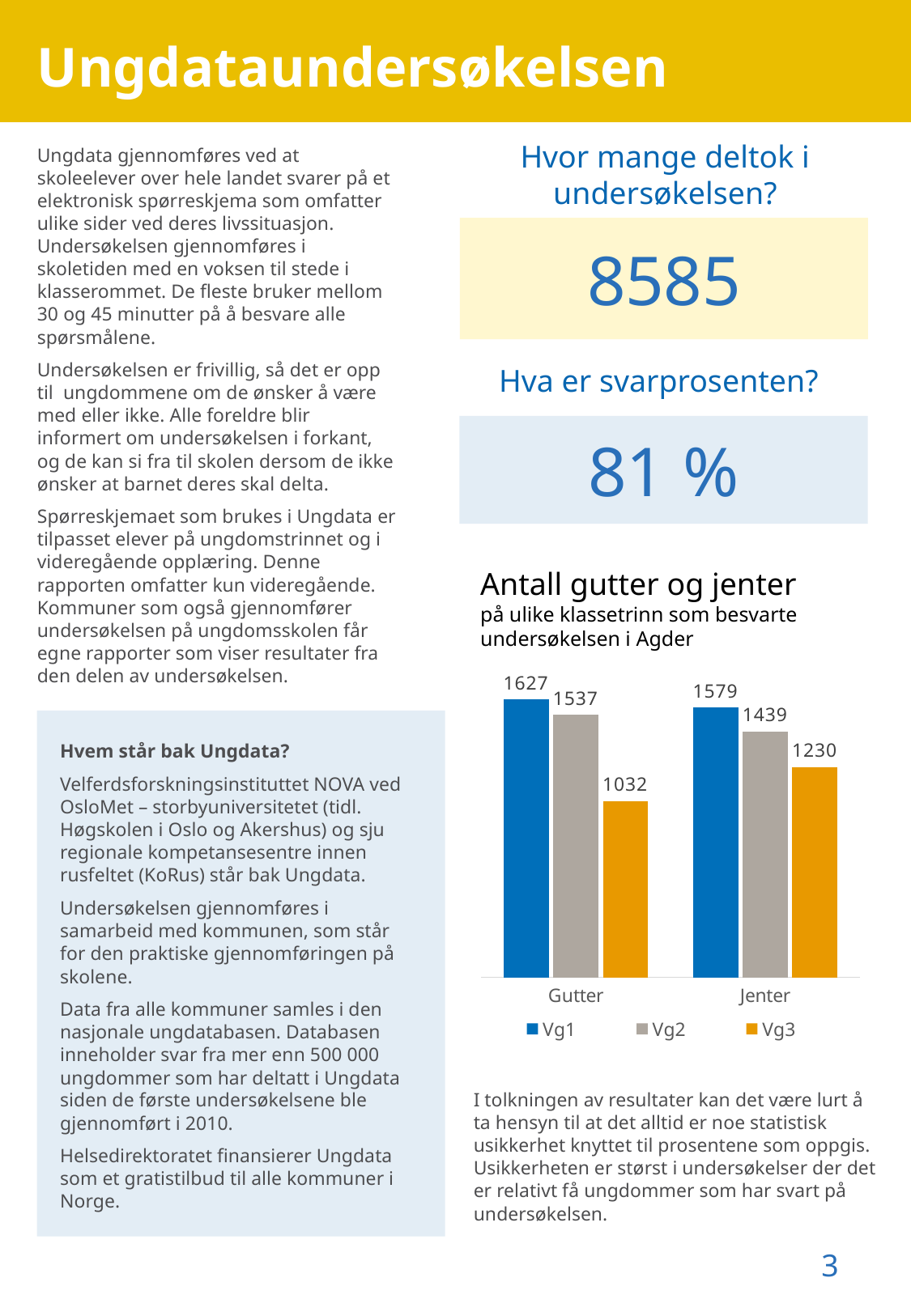
What kind of chart is shown on the slide? Bar chart What is the title of the chart? Antall gutter og jenter What is the value for Vg2 in the Gutter category? 1537 Which is larger: Vg3 for Gutter or Vg3 for Jenter? Vg3 for Jenter What is the difference between the Vg1 values for Gutter and Jenter? 48 Which series has the highest value in the Jenter category? Vg1 What is the value for Vg3 in the Jenter category? 1230 How many series does the legend list? 3 What is the value for Vg1 in the Gutter category? 1627 What is the difference between Vg2 and Vg3 in the Gutter category? 505 How many categories are shown on the x axis? 2 Which series has the lowest value in the Gutter category? Vg3